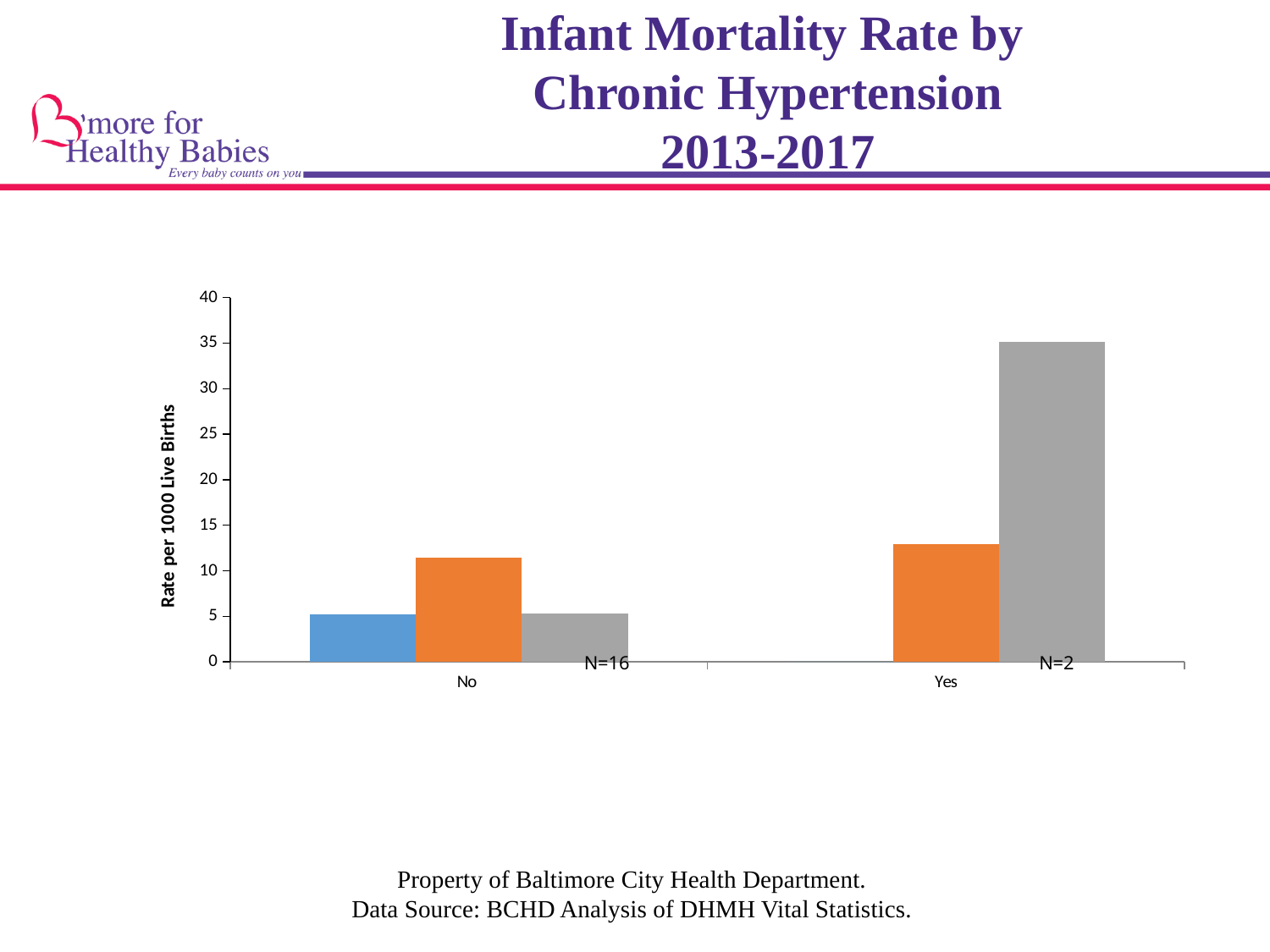
Is the value of the gray bar for the No category greater or less than 10? less What is the label of the y axis of the chart? Rate per 1000 Live Births Is the value of the orange bar for the No category greater or less than 10? greater Which is larger, the gray bar for the No category or the gray bar for the Yes category? Yes What are the two categories on the x axis of the chart? No and Yes Which category has the tallest bar in the chart? Yes How many categories are shown on the x axis of the chart? 2 What kind of chart is shown on the slide? bar chart Is the value of the orange bar for the Yes category greater or less than 15? less How many bars are plotted for the No category? 3 Which is larger, the orange bar or the gray bar for the No category? the orange bar